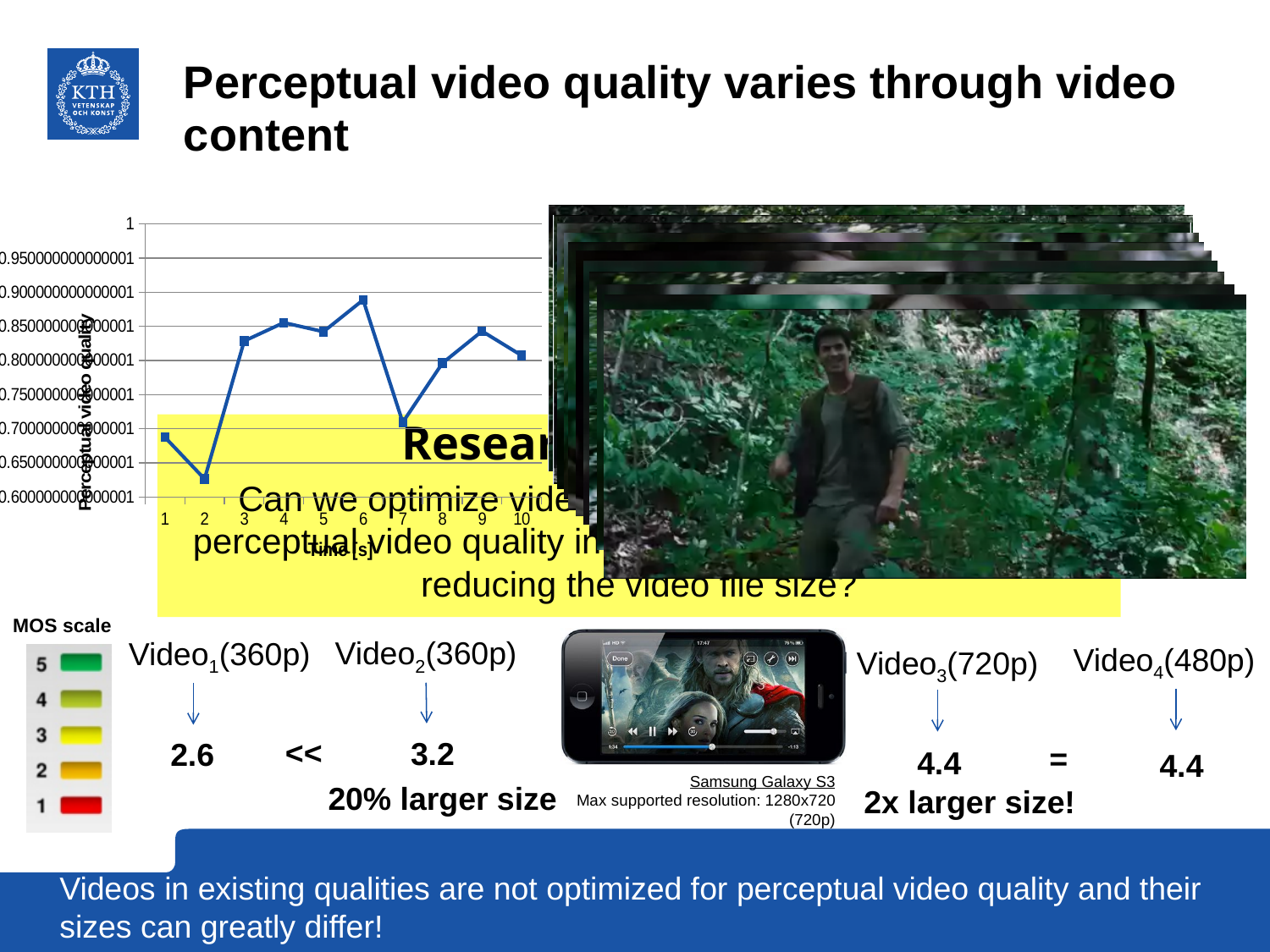
What kind of chart is shown on the slide? line chart What is the label of the x axis of the line chart? time [s] Is the perceptual video quality at time 1 greater or less than 0.65? greater Is the perceptual video quality at time 3 greater or less than 0.8? greater Which has the higher perceptual video quality, time 3 or time 7? time 3 How many time points are plotted on the line chart? 10 At which time [s] does the perceptual video quality reach its lowest value? 2 Is the perceptual video quality at time 2 greater or less than 0.65? less What is the label of the y axis of the line chart? Perceptual video quality Does the perceptual video quality rise or fall from time 1 to time 2? fall At which time [s] does the perceptual video quality reach its highest value? 6